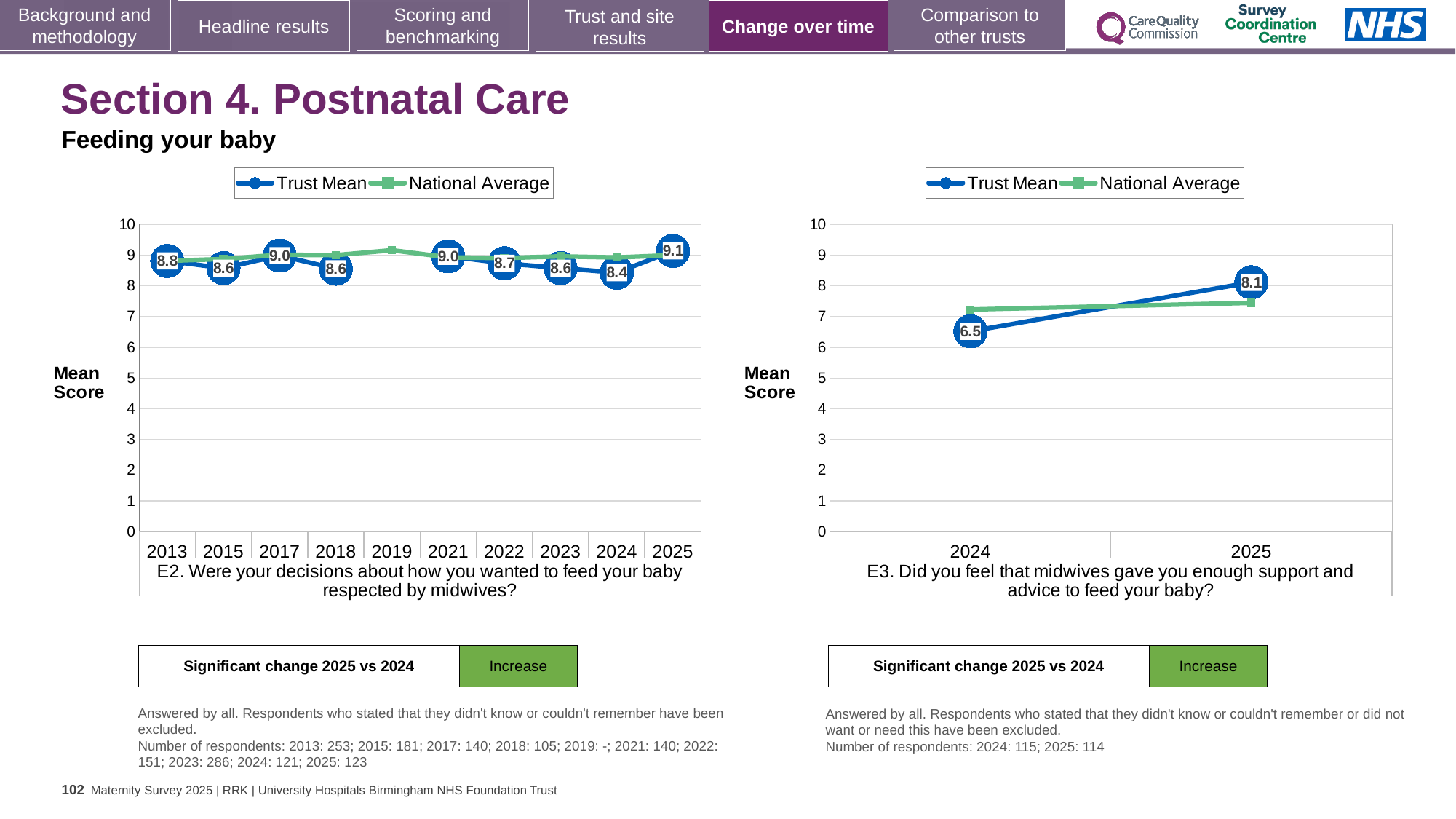
In the E3 chart (right), what is the Trust Mean for 2024? 6.5 In the E2 chart (left), how many years are shown on the x axis? 10 In the E2 chart (left), what is the Trust Mean for 2024? 8.4 In the E2 chart (left), what is the difference between the Trust Mean for 2025 and 2024? 0.7 In the E3 chart (right), by how much did the Trust Mean change from 2024 to 2025? 1.6 In the E2 chart (left), which year has the lowest labelled Trust Mean? 2024 How many series does the legend of the E3 chart (right) list? 2 In the E3 chart (right), is the National Average for 2024 greater or less than 7? greater In the E2 chart (left), is the Trust Mean for 2017 larger or smaller than the Trust Mean for 2018? larger In the E3 chart (right), what is the Trust Mean for 2025? 8.1 In the E3 chart (right), does the Trust Mean rise or fall from 2024 to 2025? rise In the E2 chart (left), what is the Trust Mean for 2025? 9.1